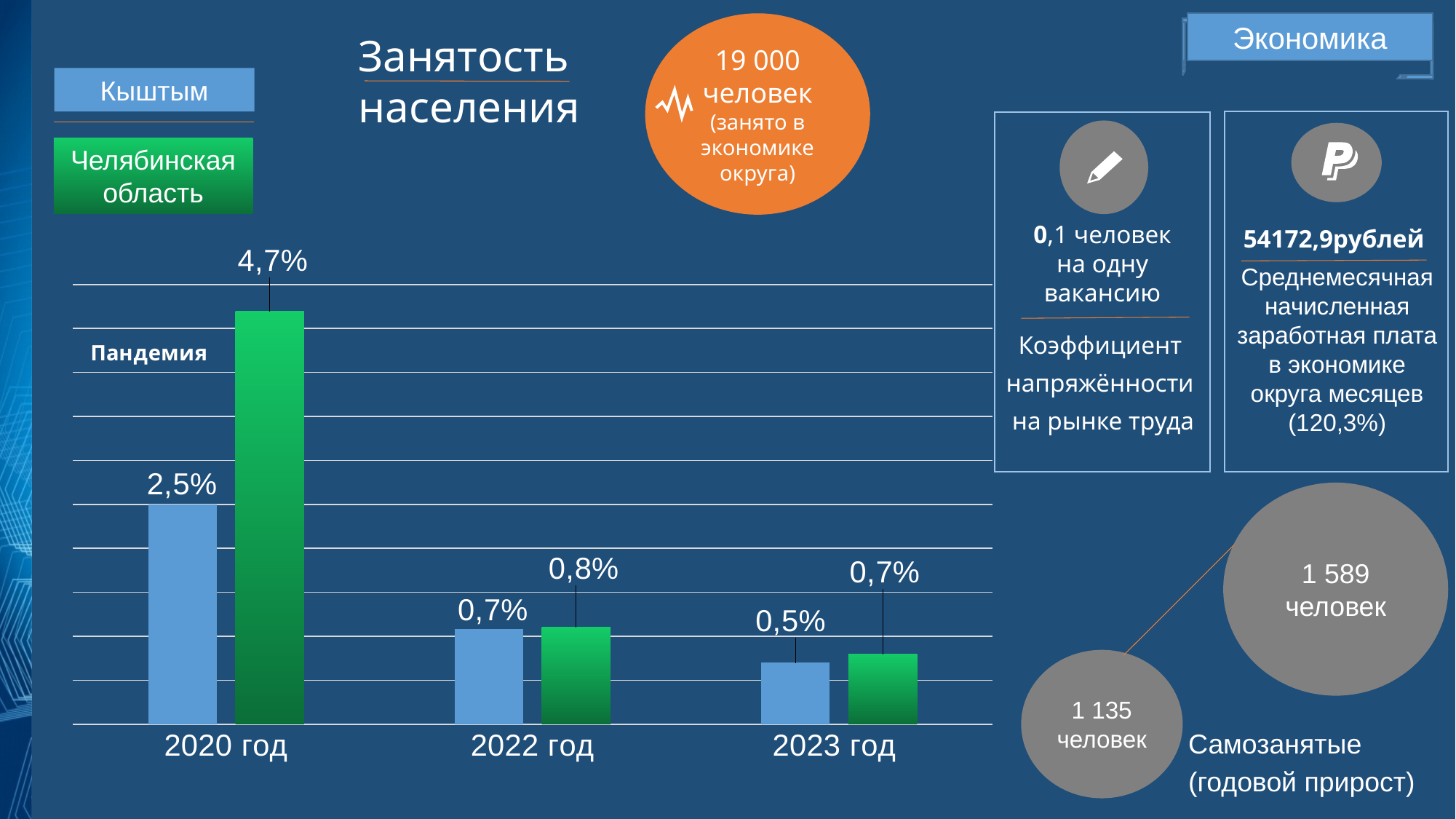
What is the difference between the Челябинская область and Кыштым values in 2020 год? 2,2% What is the value for Челябинская область in 2020 год? 4,7% In which year is the value for Кыштым lowest? 2023 год How many years are shown on the x axis of the chart? 3 What is the value for Челябинская область in 2022 год? 0,8% What is the value for Кыштым in 2023 год? 0,5% In which year is the value for Челябинская область highest? 2020 год What is the value for Кыштым in 2020 год? 2,5% How many series does the chart show? 2 What kind of chart is shown on the slide? Bar chart Do the values for Кыштым rise or fall from 2020 год to 2023 год? Fall Which is larger in 2023 год: the value for Кыштым or for Челябинская область? Челябинская область